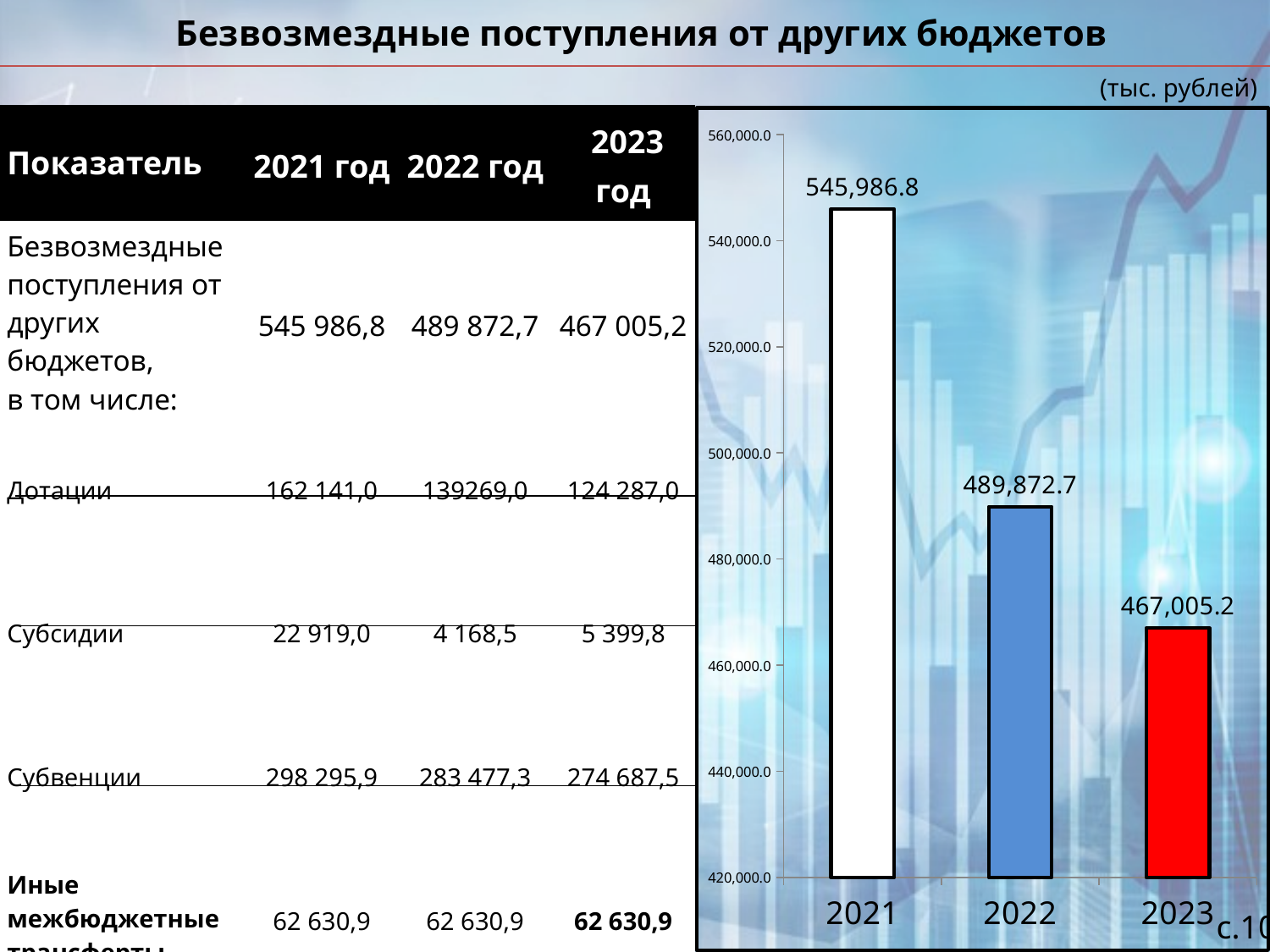
Is the value for 2023 in the bar chart greater or less than 480,000.0? less What is the value shown for 2022 in the bar chart? 489,872.7 What type of chart is shown on the slide? bar chart How many bars are plotted in the chart? 3 Do the values in the bar chart rise or fall from 2021 to 2023? fall Which year has the lowest bar in the chart? 2023 What is the difference between the 2021 and 2022 values in the bar chart? 56,114.1 What is the difference between the 2022 and 2023 values in the bar chart? 22,867.5 Which year has the highest bar in the chart? 2021 What is the value shown for 2023 in the bar chart? 467,005.2 What is the value shown for 2021 in the bar chart? 545,986.8 Which is larger in the bar chart, the value for 2022 or the value for 2023? 2022